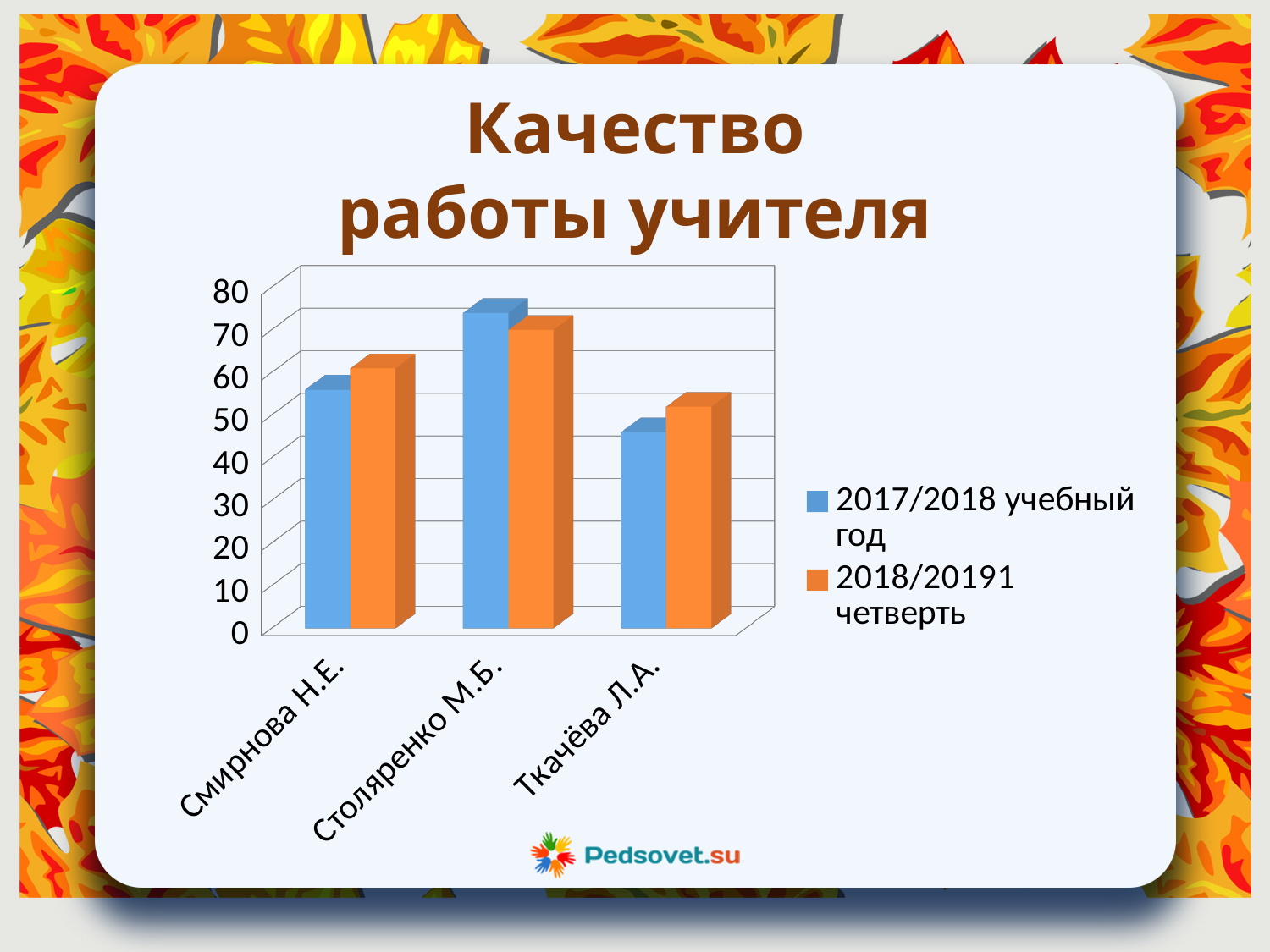
Which teacher has the highest value for the 2017/2018 учебный год series? Столяренко М.Б. Which teacher has the lowest value for the 2017/2018 учебный год series? Ткачёва Л.А. How many teachers (categories) are shown on the x axis of the chart? 3 For Смирнова Н.Е., which series has the larger value: 2017/2018 учебный год or 2018/2019 1 четверть? 2018/2019 1 четверть What is the title of the slide containing the chart? Качество работы учителя Is the 2017/2018 учебный год value for Ткачёва Л.А. greater or less than 50? less Which colour represents the 2018/2019 1 четверть series in the chart? orange For Столяренко М.Б., which series has the larger value: 2017/2018 учебный год or 2018/2019 1 четверть? 2017/2018 учебный год How many series does the chart legend list? 2 What kind of chart is shown on the slide? bar chart Is the 2017/2018 учебный год value for Столяренко М.Б. greater or less than 60? greater Which teacher has the lowest value for the 2018/2019 1 четверть series? Ткачёва Л.А.